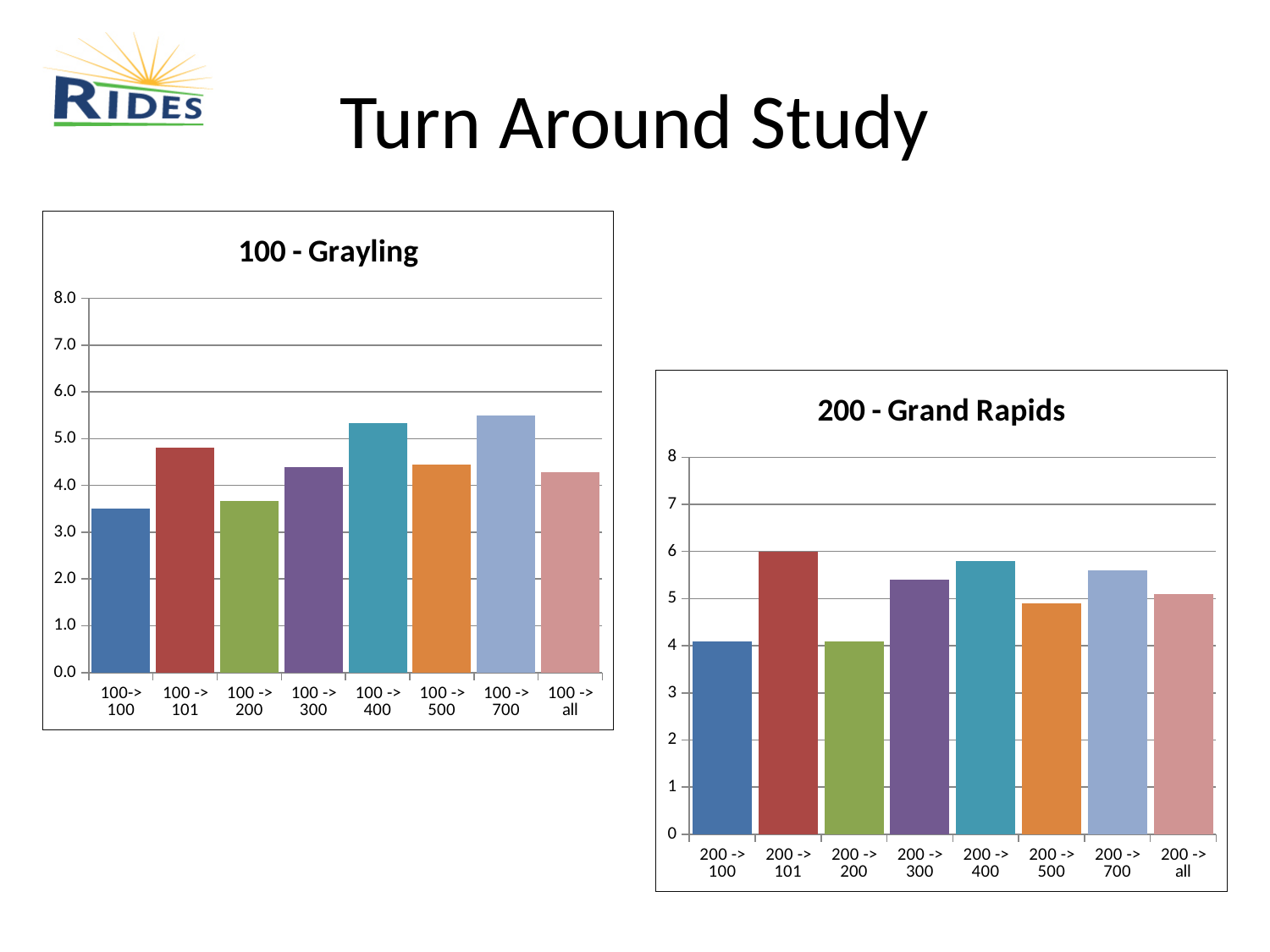
In the "200 - Grand Rapids" chart, which is larger, the value for 200 -> 400 or the value for 200 -> 200? 200 -> 400 What kind of chart is the "100 - Grayling" chart? bar chart In the "100 - Grayling" chart, is the value for 100-> 100 greater or less than 4.0? less What is the title of the chart on the left side of the slide? 100 - Grayling In the "200 - Grand Rapids" chart, is the value for 200 -> 500 greater or less than 5? less In the "100 - Grayling" chart, is the value for 100 -> 101 greater or less than 4.0? greater In the "100 - Grayling" chart, which is larger, the value for 100 -> 101 or the value for 100-> 100? 100 -> 101 How many bars are shown in the "200 - Grand Rapids" chart? 8 In the "200 - Grand Rapids" chart, which category has the highest value? 200 -> 101 What is the highest value shown on the vertical axis of the "200 - Grand Rapids" chart? 8